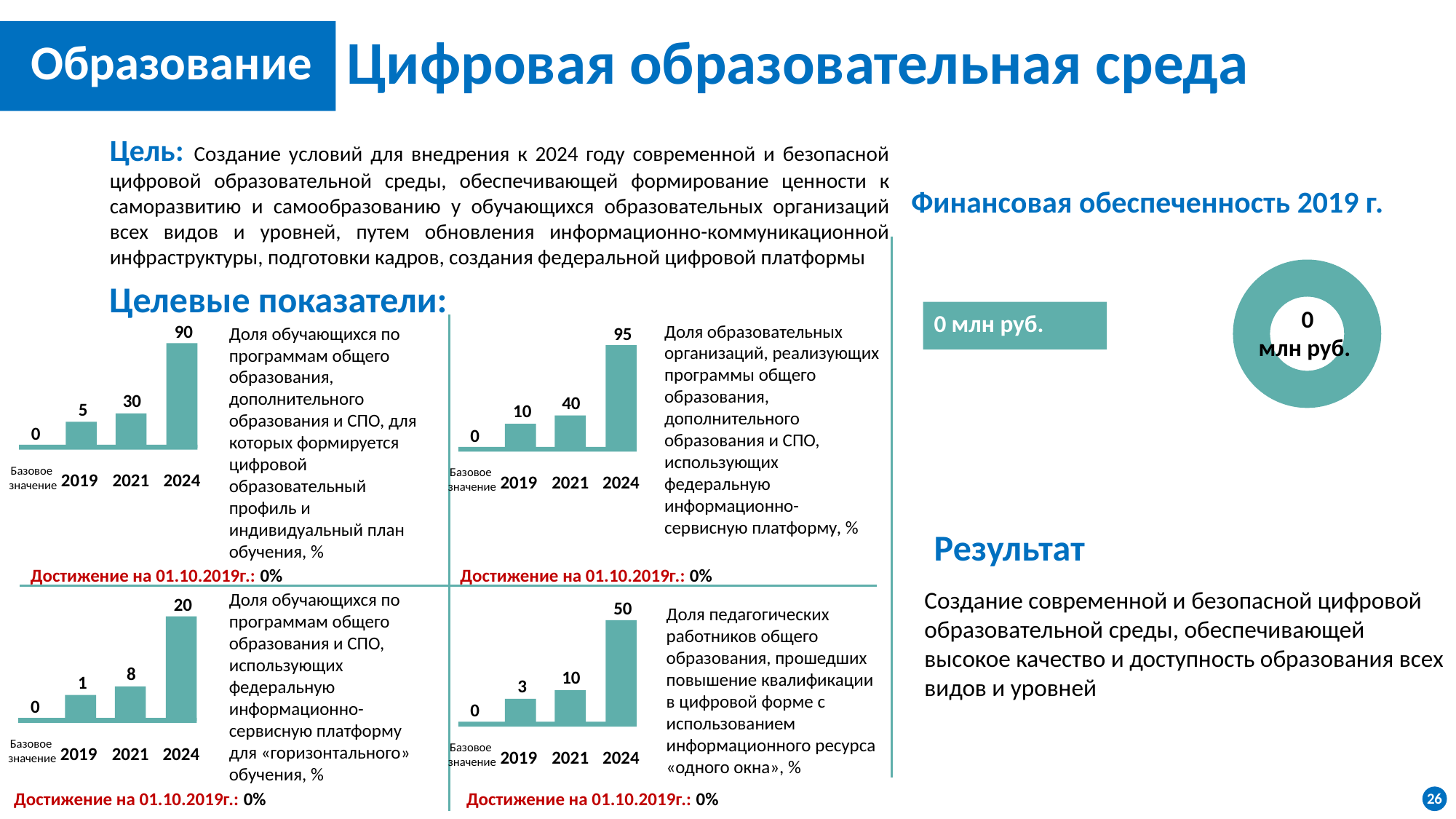
In the top-right bar chart, what is the value for 2021? 40 In the top-left bar chart, what is the difference between the values for 2024 and 2021? 60 In the top-left bar chart, what is the value for 2024? 90 In the bottom-left bar chart, what is the value for 2019? 1 In the bottom-left bar chart, do the values rise or fall from the base value to 2024? rise How many bars are shown in the bottom-right bar chart? 3 In the top-right bar chart, which is larger: the value for 2019 or the value for 2021? 2021 In the bottom-right bar chart, which category has the lowest value? Базовое значение In the bottom-left bar chart, what is the difference between the values for 2021 and 2019? 7 What type of chart is the top-left chart under 'Целевые показатели'? bar chart In the top-right bar chart, which category has the highest value? 2024 In the bottom-right bar chart, what is the value for 2024? 50